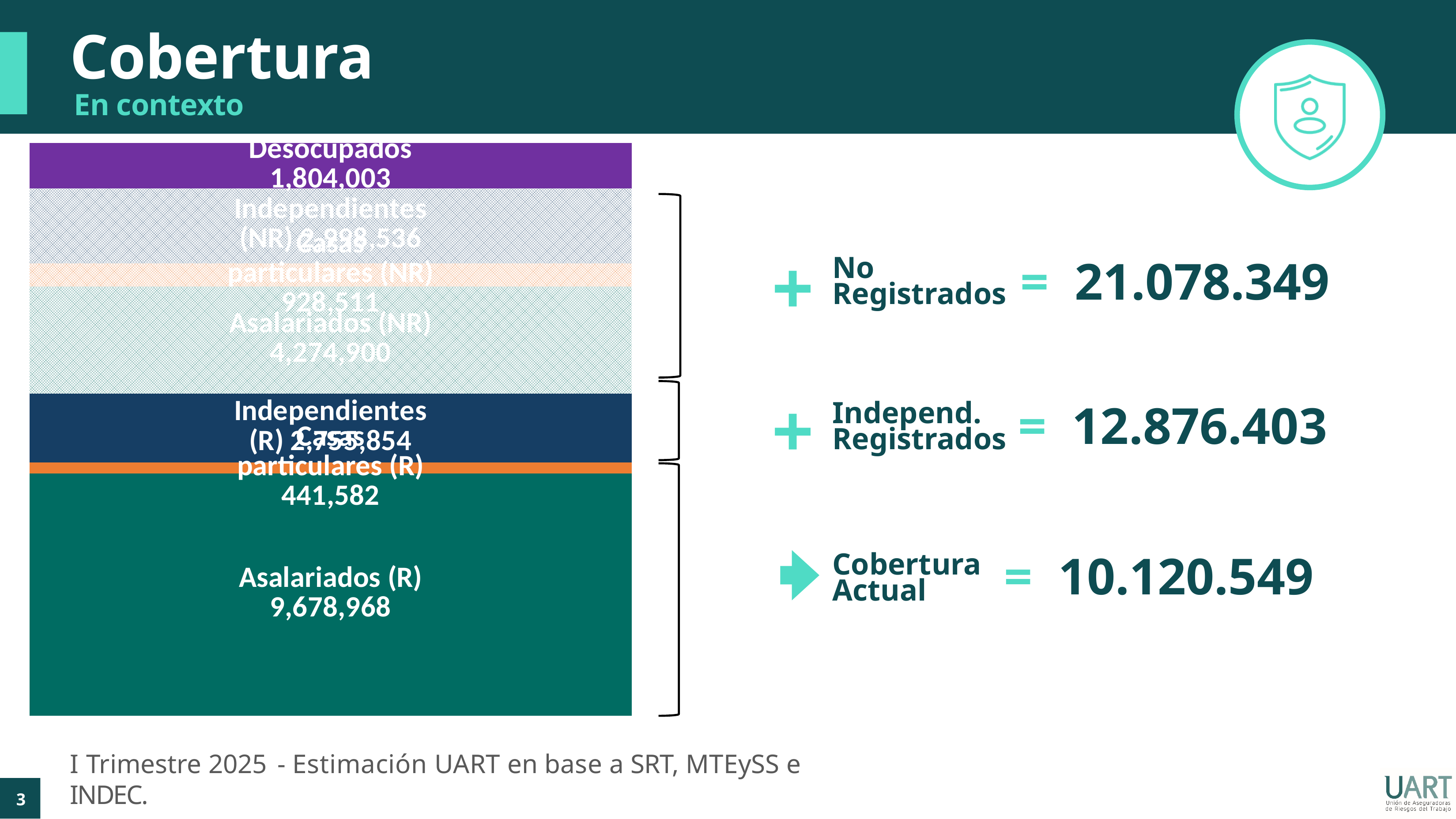
What is the difference between the Asalariados (R) and Asalariados (NR) values? 5,404,068 What value is shown for the Casas particulares (R) segment? 441,582 What value is shown for the Asalariados (NR) segment? 4,274,900 What is the difference between the Desocupados and Casas particulares (NR) values? 875,492 How many segments make up the stacked bar? 7 Which segment of the stacked bar has the smallest value? Casas particulares (R) What value is shown for the Asalariados (R) segment of the stacked bar? 9,678,968 What value is shown for the Desocupados segment of the stacked bar? 1,804,003 Which is larger, Desocupados or Asalariados (NR)? Asalariados (NR) Which segment of the stacked bar has the largest value? Asalariados (R) What value is shown for the Casas particulares (NR) segment? 928,511 What kind of chart is shown on the slide? Stacked bar chart